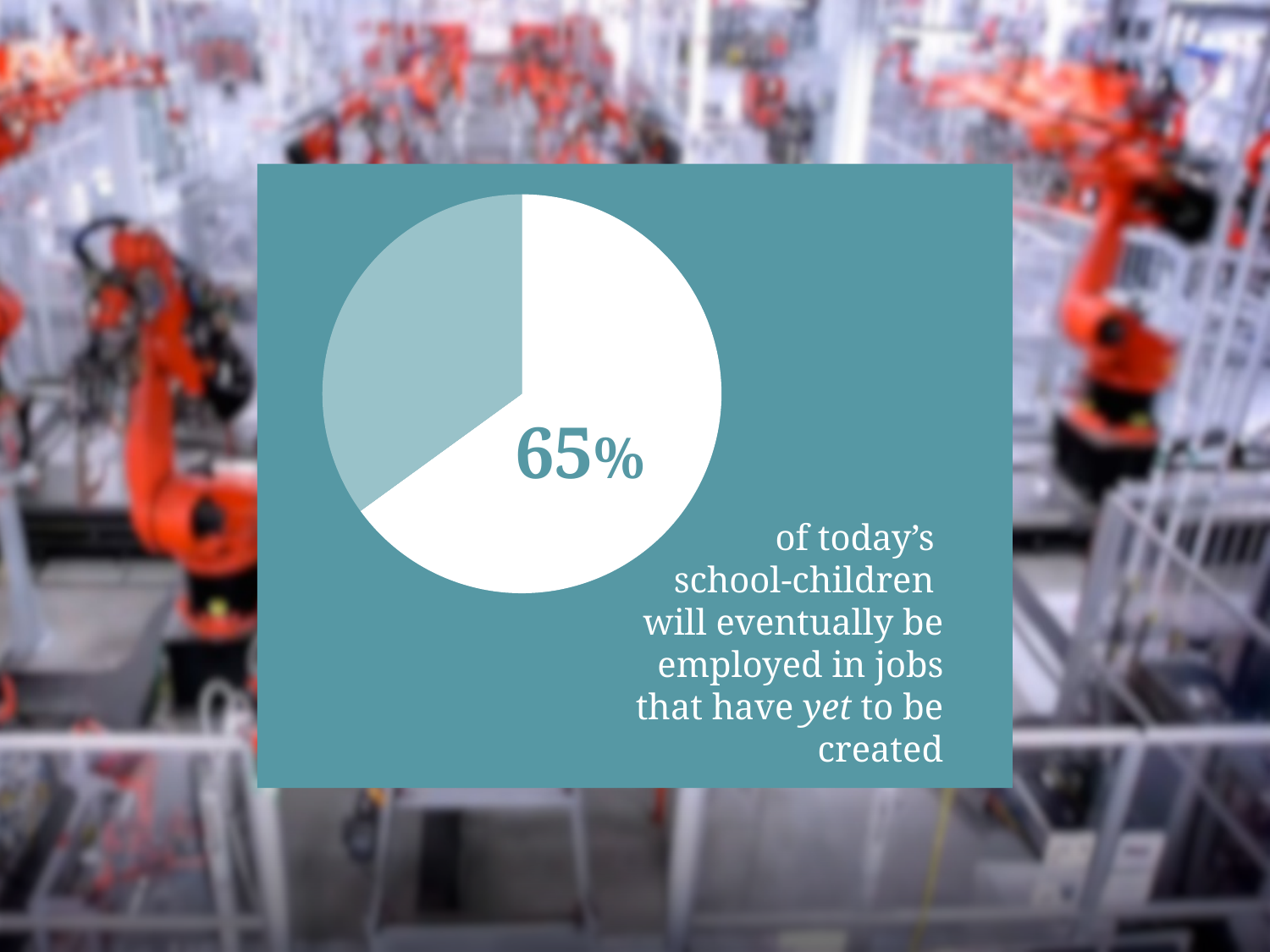
Is the white slice of the pie chart greater or less than 50% of the pie? greater What percentage is printed on the white slice of the pie chart? 65% What share of the pie does the white slice represent? 65% What kind of chart is shown on the slide? pie chart How many slices does the pie chart have? 2 What colour is the slice of the pie chart labelled 65%? white Is the light teal slice of the pie chart greater or less than 50% of the pie? less According to the text next to the pie chart, what does the 65% slice represent? today's school-children who will eventually be employed in jobs that have yet to be created Which slice of the pie chart is larger, the white slice or the light teal slice? the white slice